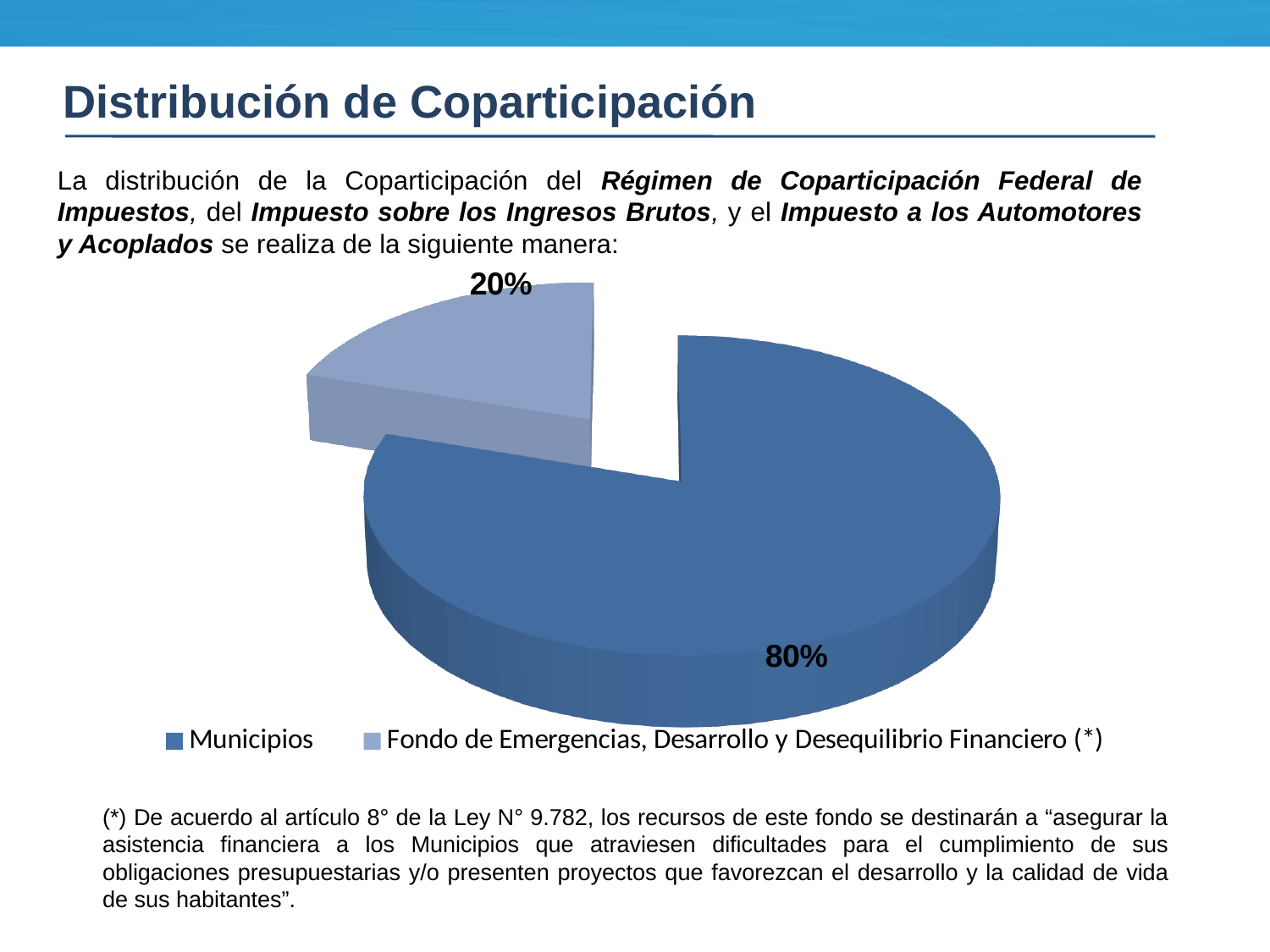
What is the difference in percentage points between the Municipios slice and the Fondo de Emergencias, Desarrollo y Desequilibrio Financiero (*) slice? 60 percentage points Which is larger: the share for Municipios or the share for Fondo de Emergencias, Desarrollo y Desequilibrio Financiero (*)? Municipios Which category has the smallest slice of the pie? Fondo de Emergencias, Desarrollo y Desequilibrio Financiero (*) Which slice is pulled out (exploded) from the pie? Fondo de Emergencias, Desarrollo y Desequilibrio Financiero (*) What kind of chart is shown on the slide? Pie chart How many entries does the legend list? 2 How many slices does the pie chart have? 2 What share of the pie does Fondo de Emergencias, Desarrollo y Desequilibrio Financiero (*) receive? 20% What colour is the Municipios slice in the pie chart? Dark blue Which category has the largest slice of the pie? Municipios What share of the pie does Municipios receive? 80%